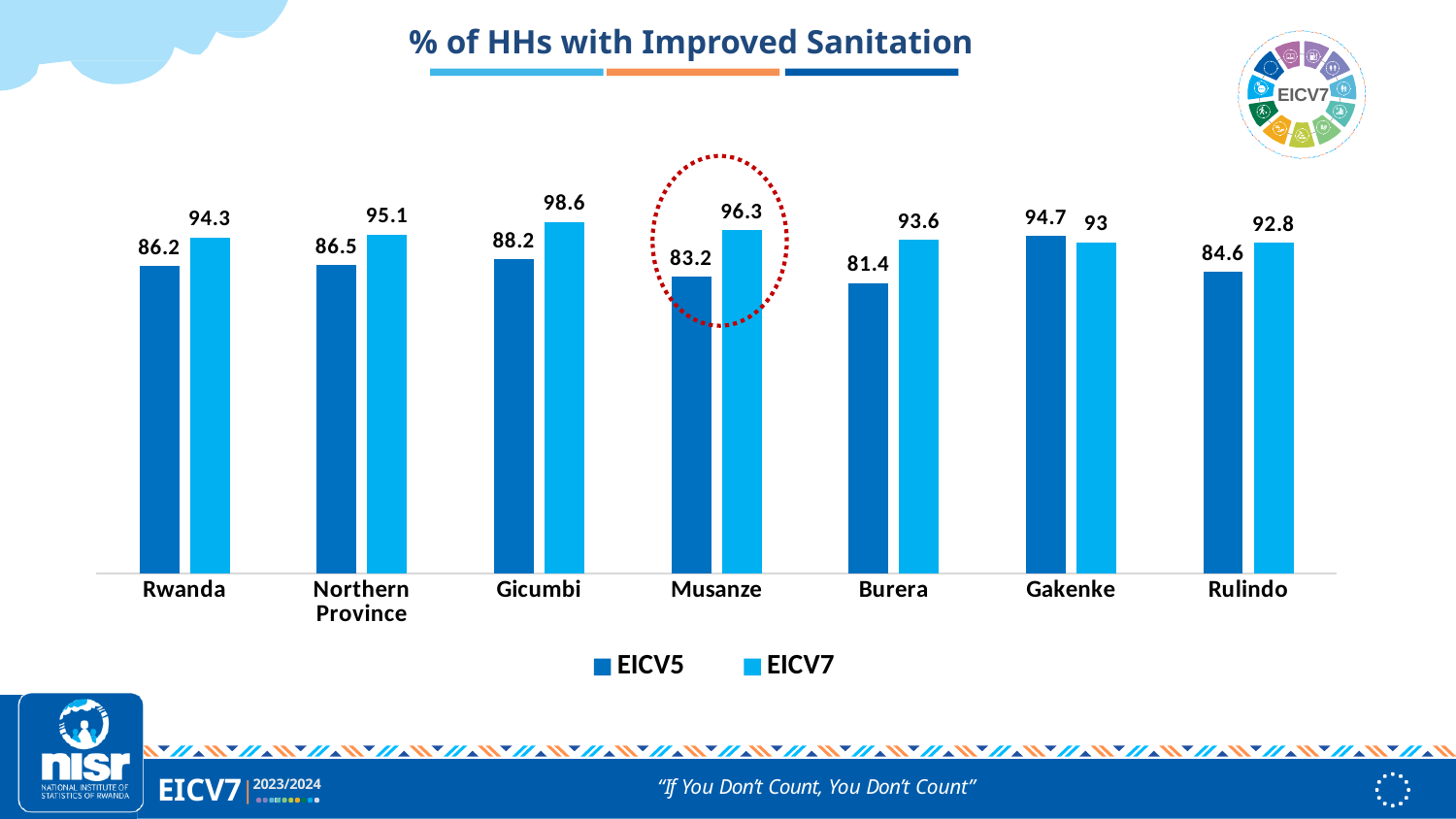
What is the title of the chart? % of HHs with Improved Sanitation What is the EICV7 value for Gicumbi? 98.6 What is the EICV7 value for Rulindo? 92.8 Which is larger for Gakenke, the EICV5 value or the EICV7 value? EICV5 Which category has the lowest EICV5 value? Burera What kind of chart is shown on the slide? Bar chart What is the difference between the EICV7 and EICV5 values for Musanze? 13.1 Which category is highlighted with a red dotted circle? Musanze What is the EICV5 value for Musanze? 83.2 How many series does the legend list? 2 Which category has the highest EICV7 value? Gicumbi How many categories are shown on the x axis? 7